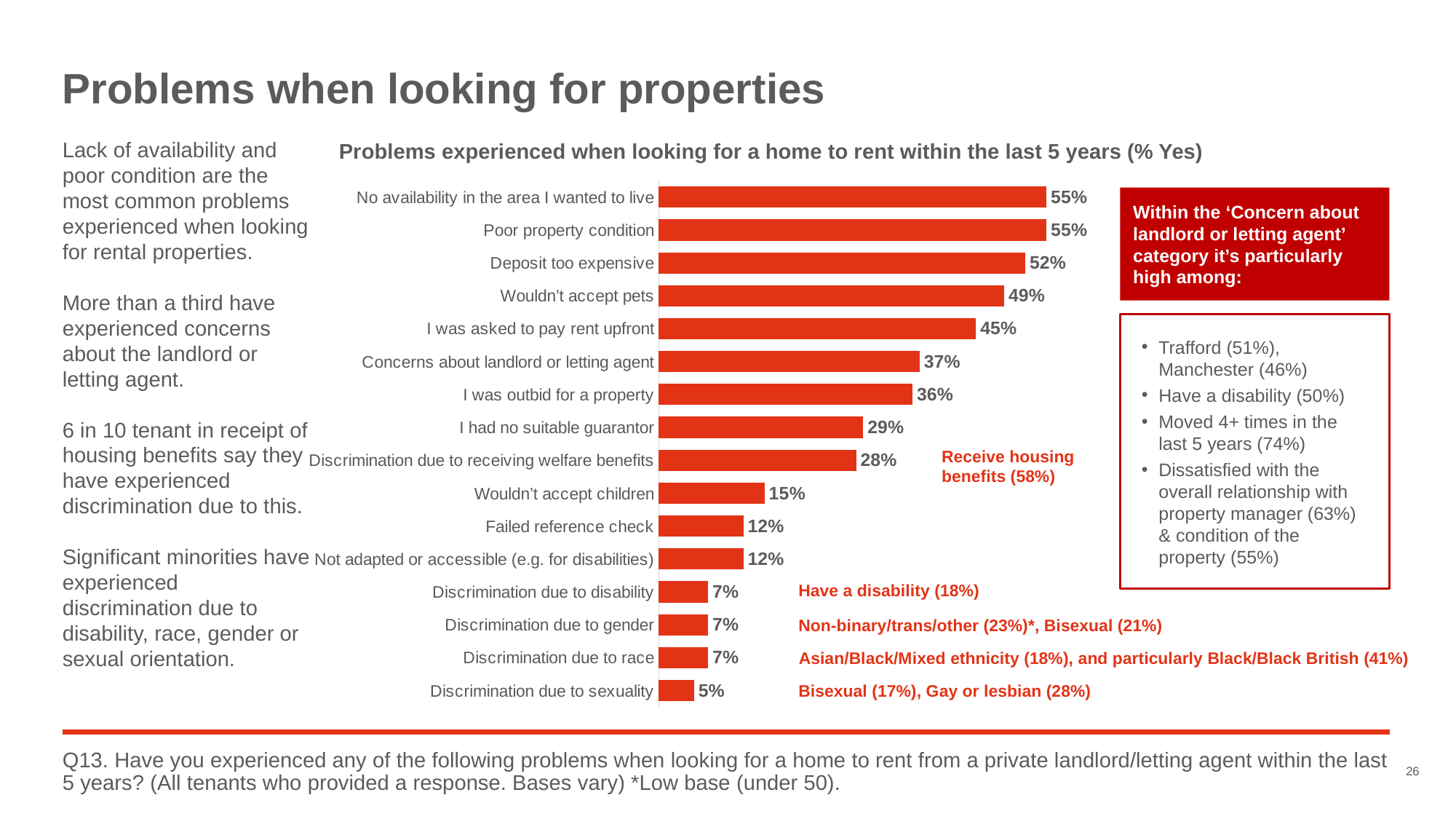
What is the value for 'Concerns about landlord or letting agent'? 37% What percentage of tenants reported 'Deposit too expensive' as a problem? 52% What is the value for 'Discrimination due to sexuality'? 5% Which problem has the lowest percentage in the chart? Discrimination due to sexuality What is the title of the chart? Problems experienced when looking for a home to rent within the last 5 years (% Yes) What is the difference between 'I had no suitable guarantor' and 'Discrimination due to receiving welfare benefits'? 1 percentage point What percentage said 'Wouldn't accept children'? 15% How many problem categories are shown in the chart? 16 Which is larger: 'Poor property condition' or 'Deposit too expensive'? Poor property condition What type of chart is used on this slide? Bar chart What is the difference between 'Wouldn't accept pets' and 'I was asked to pay rent upfront'? 4 percentage points Which is larger: 'I was outbid for a property' or 'Wouldn't accept children'? I was outbid for a property